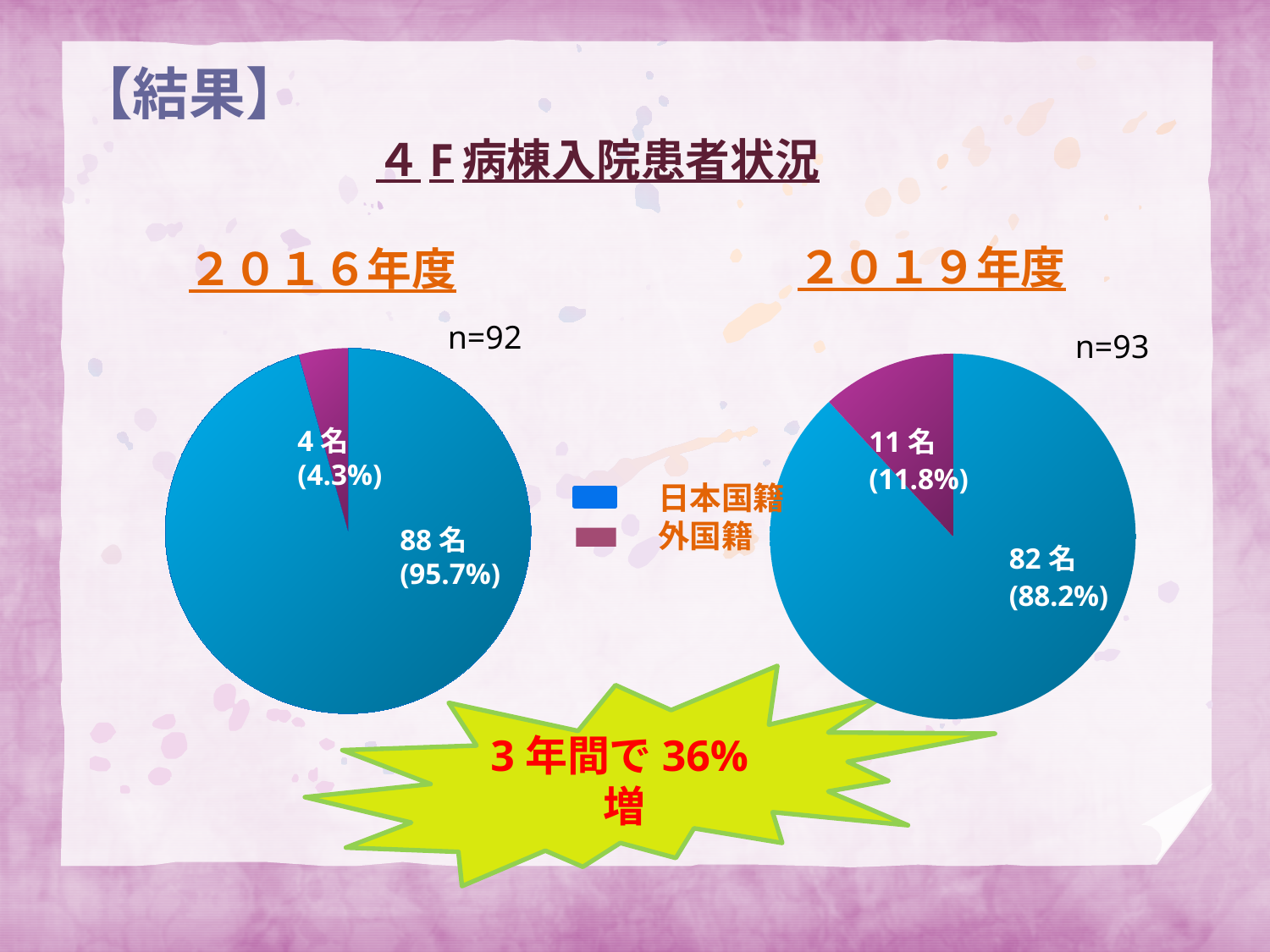
In the 2019年度 pie chart, what percentage of patients are 日本国籍? 88.2% In the 2016年度 pie chart, what percentage of patients are 外国籍? 4.3% In the 2019年度 pie chart, how many patients are 外国籍? 11 名 How many categories does the legend list? 2 In the 2019年度 pie chart, which category has the largest slice? 日本国籍 In the 2016年度 pie chart, which category has the smallest slice? 外国籍 In the 2016年度 pie chart, how many patients are 日本国籍? 88 名 What is the difference in the number of 外国籍 patients between the 2019年度 chart and the 2016年度 chart? 7 名 What is the sample size (n) shown for the 2019年度 chart? n=93 Which colour represents 外国籍 in the legend? Purple Which chart shows a larger number of 日本国籍 patients, 2016年度 or 2019年度? 2016年度 What type of chart is used for 2016年度 and 2019年度? Pie chart